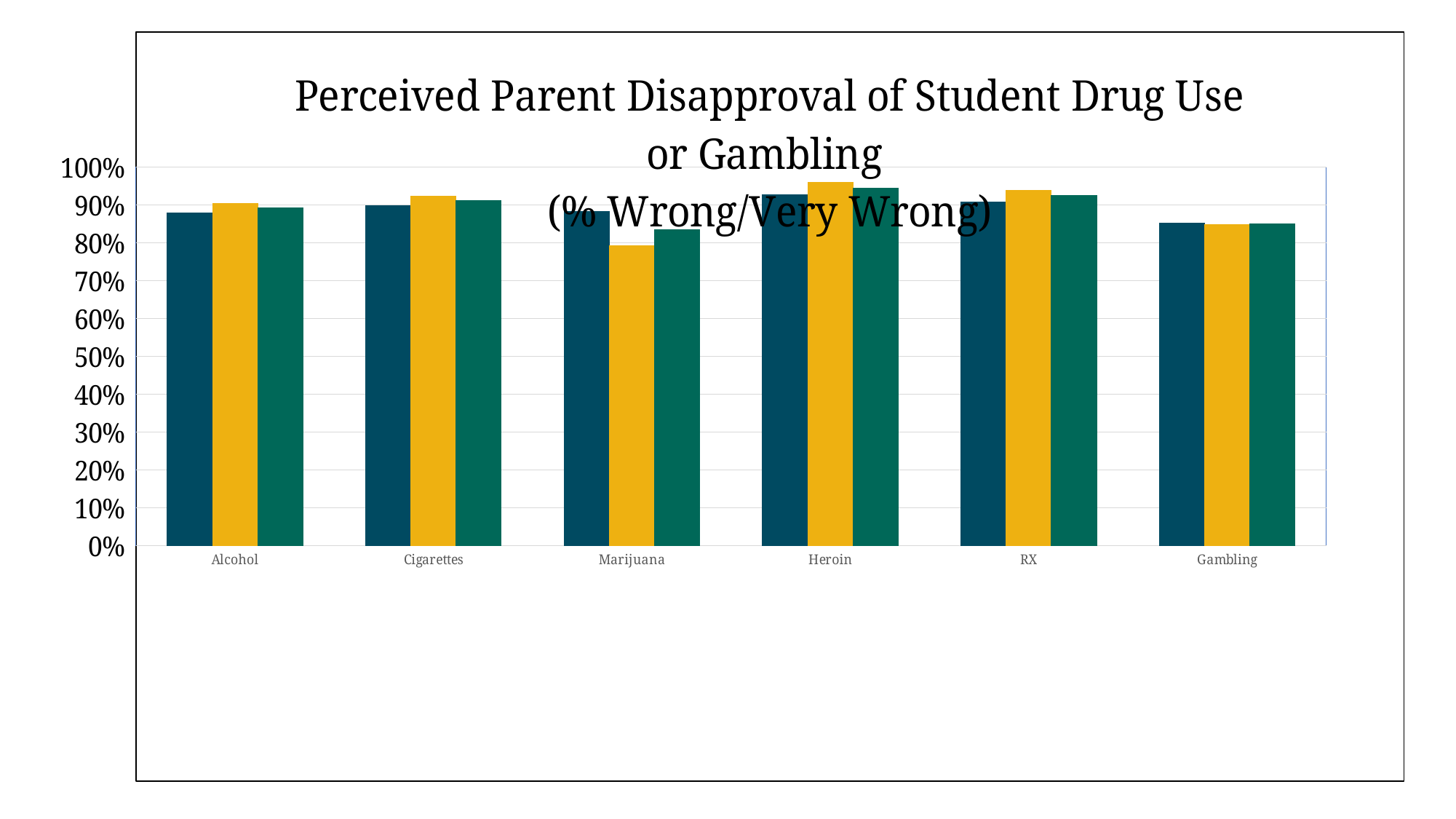
Which is larger, the yellow bar for Heroin or the yellow bar for Marijuana? Heroin What kind of chart is shown on the slide? bar chart What is the title of the chart? Perceived Parent Disapproval of Student Drug Use or Gambling (% Wrong/Very Wrong) Is the value of the yellow bar for Heroin greater or less than 90%? greater Which category contains the shortest bar in the chart? Marijuana Which category contains the tallest bar in the chart? Heroin How many categories are shown on the x axis of the chart? 6 Is the value of the green bar for Gambling greater or less than 80%? greater Is the value of the dark blue bar for Gambling greater or less than 90%? less Which is larger, the yellow bar for Cigarettes or the yellow bar for Gambling? Cigarettes How many bars are plotted for each category in the chart? 3